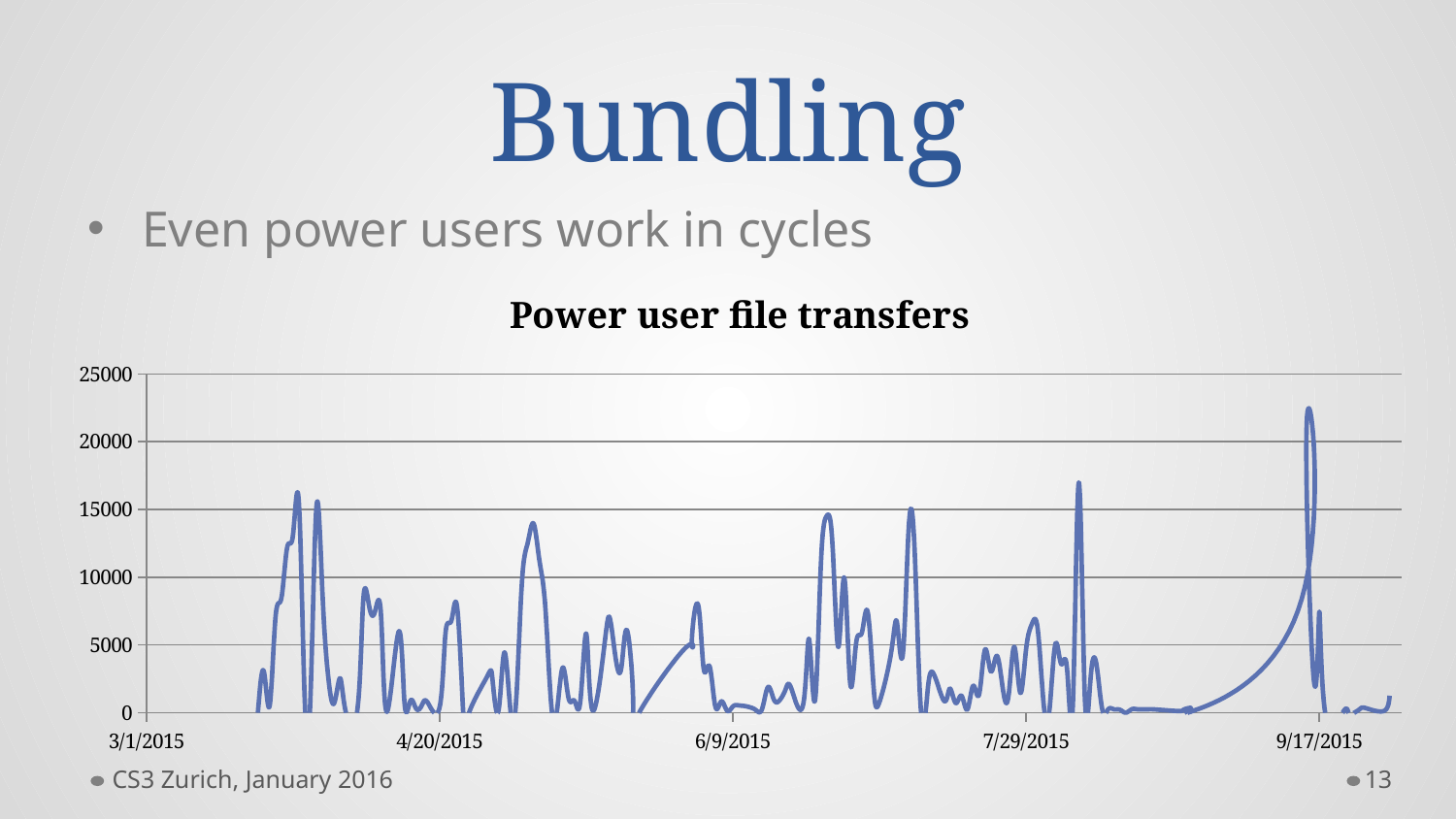
Is the value of the line at the 9/17/2015 tick greater or less than 5000? greater Does the highest peak of the line occur before or after the 7/29/2015 tick on the x axis? after Is the highest peak of the line greater or less than 20000? greater What kind of chart is shown on the slide? line chart What is the title of the chart? Power user file transfers What is the first date label shown on the x axis? 3/1/2015 What is the highest value shown on the y axis of the chart? 25000 Is the tallest peak between 7/29/2015 and 9/17/2015 (the one shortly after 7/29/2015) greater or less than 15000? greater How many lines (data series) are plotted on the chart? 1 How many date labels are shown along the x axis of the chart? 5